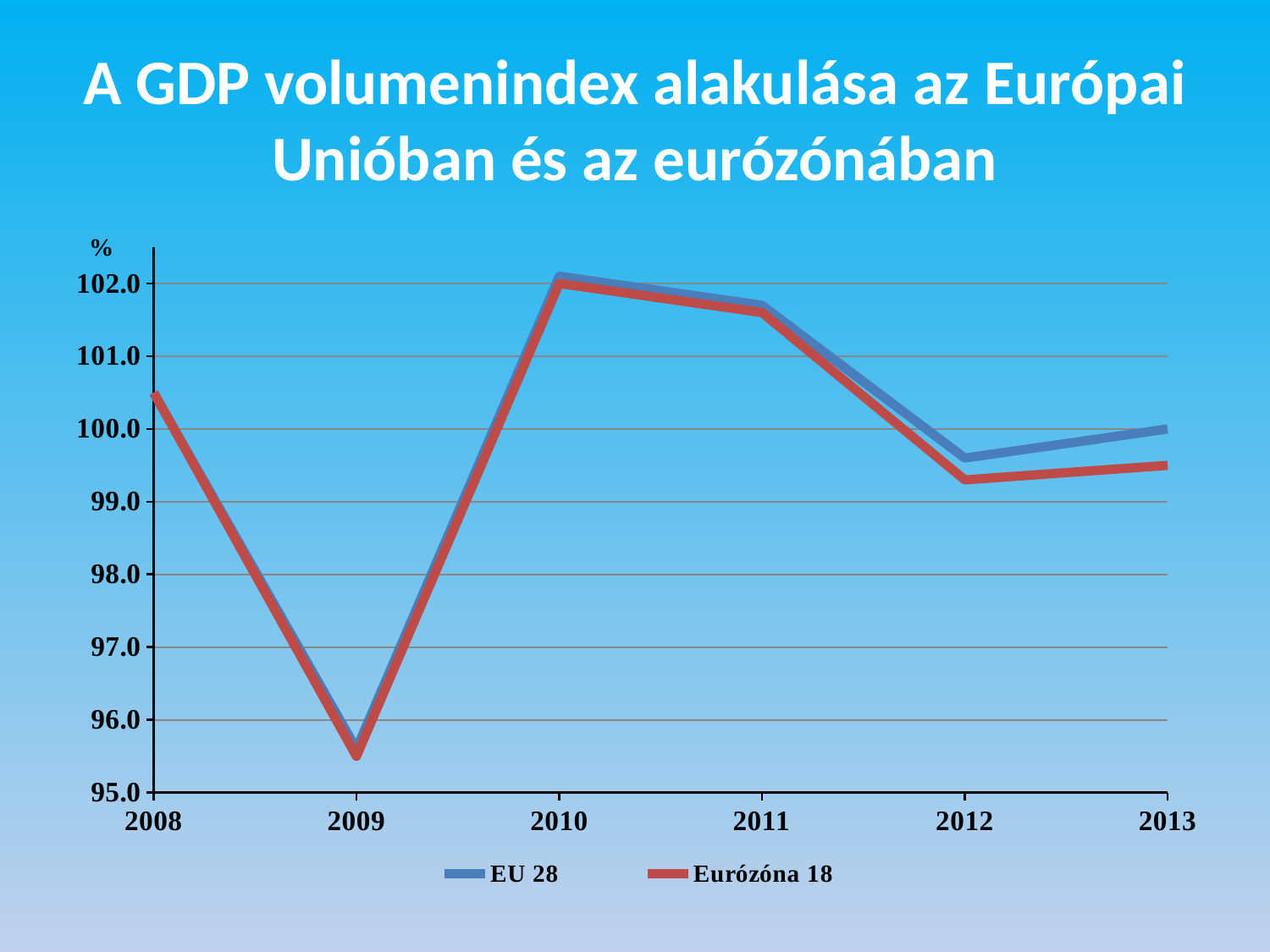
In which year does the EU 28 series reach its lowest value? 2009 Do the values rise or fall from 2008 to 2009? fall How many series does the legend list? 2 Do the values rise or fall from 2009 to 2010? rise Which series has the higher value in 2013, EU 28 or Eurózóna 18? EU 28 What kind of chart is shown on the slide? line chart In which year does the Eurózóna 18 series reach its highest value? 2010 Is the value for Eurózóna 18 in 2010 greater or less than 101.0? greater How many years are shown on the x axis? 6 Which colour is used for the Eurózóna 18 series? red Is the value for EU 28 in 2009 greater or less than 96.0? less Is the value for Eurózóna 18 in 2012 greater or less than 100.0? less